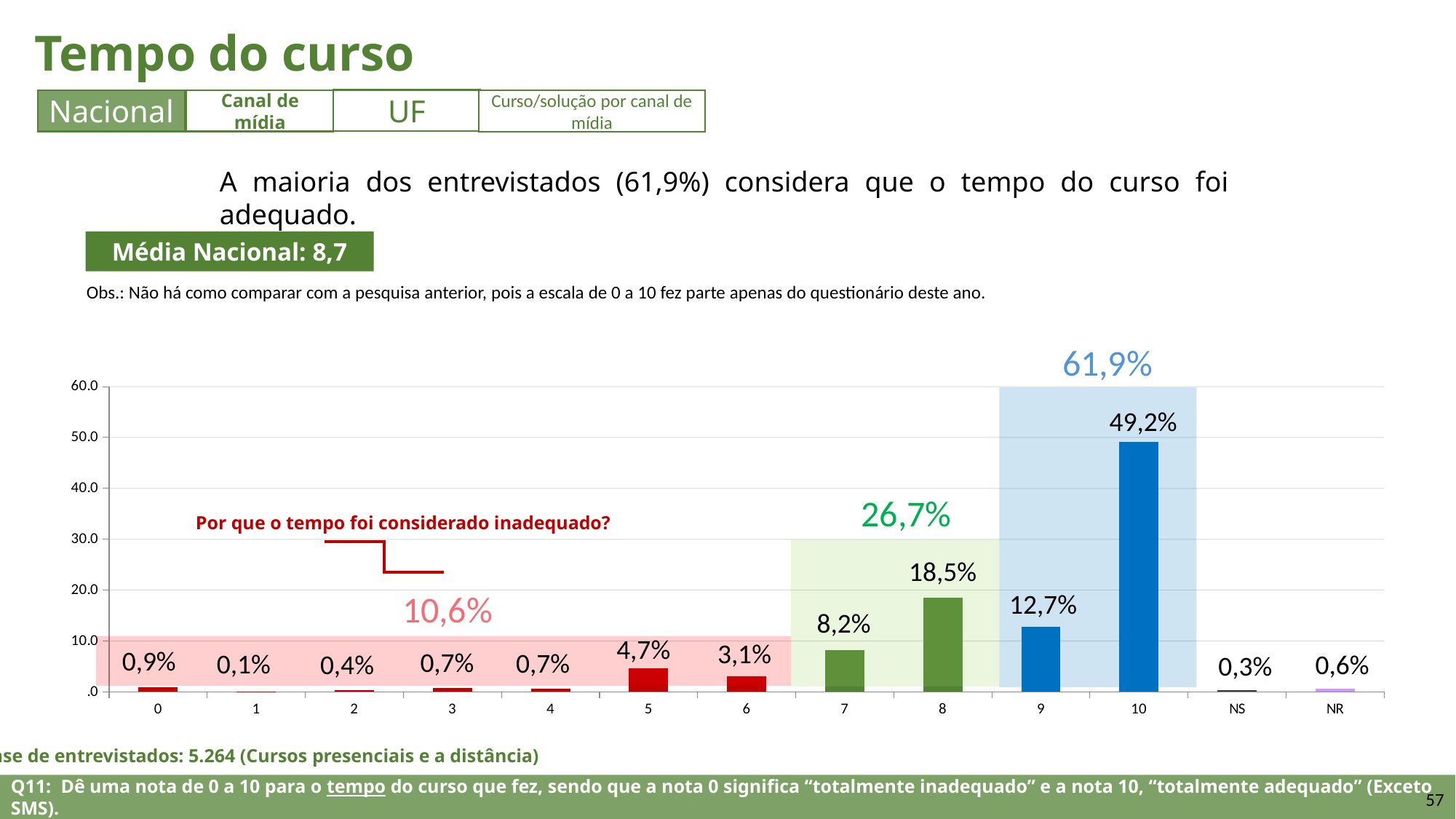
How many categories are shown on the x axis? 13 What is the difference between the values for category 10 and category 8? 30,7% Which category has the lowest value? 1 Which category has the highest value? 10 What value is shown for category 10? 49,2% What combined percentage is shown for the group of categories 9 and 10? 61,9% Which is larger, the value for category 8 or category 9? 8 Is the value for category 10 greater or less than 40? greater What value is shown for the NR category? 0,6% What value is shown for category 8? 18,5% What value is shown for category 5? 4,7% What kind of chart is shown on the slide? bar chart